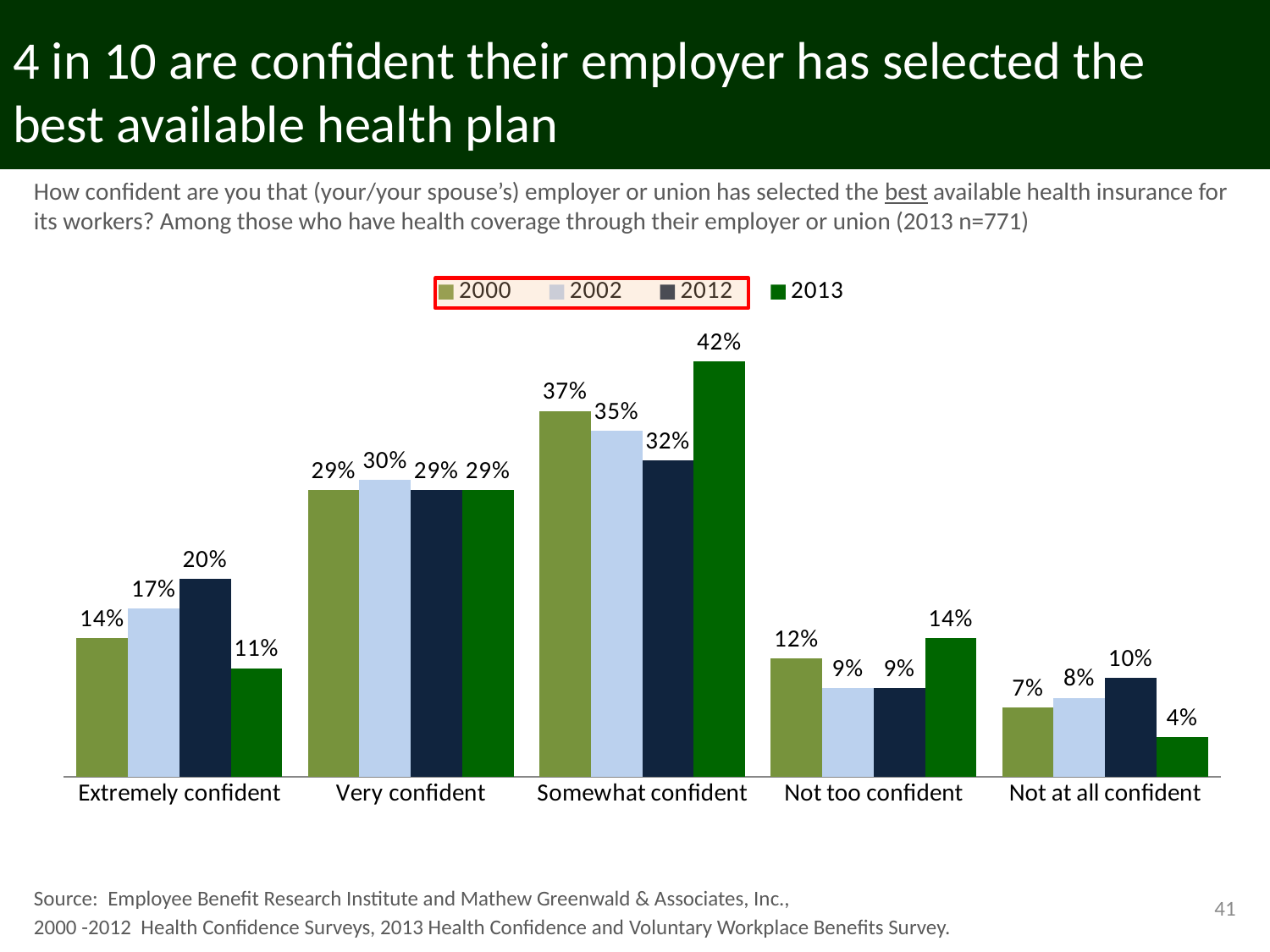
Which category has the highest value for the 2013 series? Somewhat confident How many series does the legend list? 4 In the Not too confident category, which is larger: the 2000 value or the 2013 value? 2013 What is the value for 2012 in the Not at all confident category? 10% What is the value for 2000 in the Extremely confident category? 14% What is the difference between the 2012 and 2013 values in the Extremely confident category? 9% What is the difference between the 2013 and 2012 values in the Somewhat confident category? 10% How many categories are shown on the x axis? 5 Which series is shown in the lightest (pale blue) colour? 2002 What kind of chart is shown on the slide? Bar chart Which category has the lowest value for the 2013 series? Not at all confident What is the value for 2013 in the Somewhat confident category? 42%